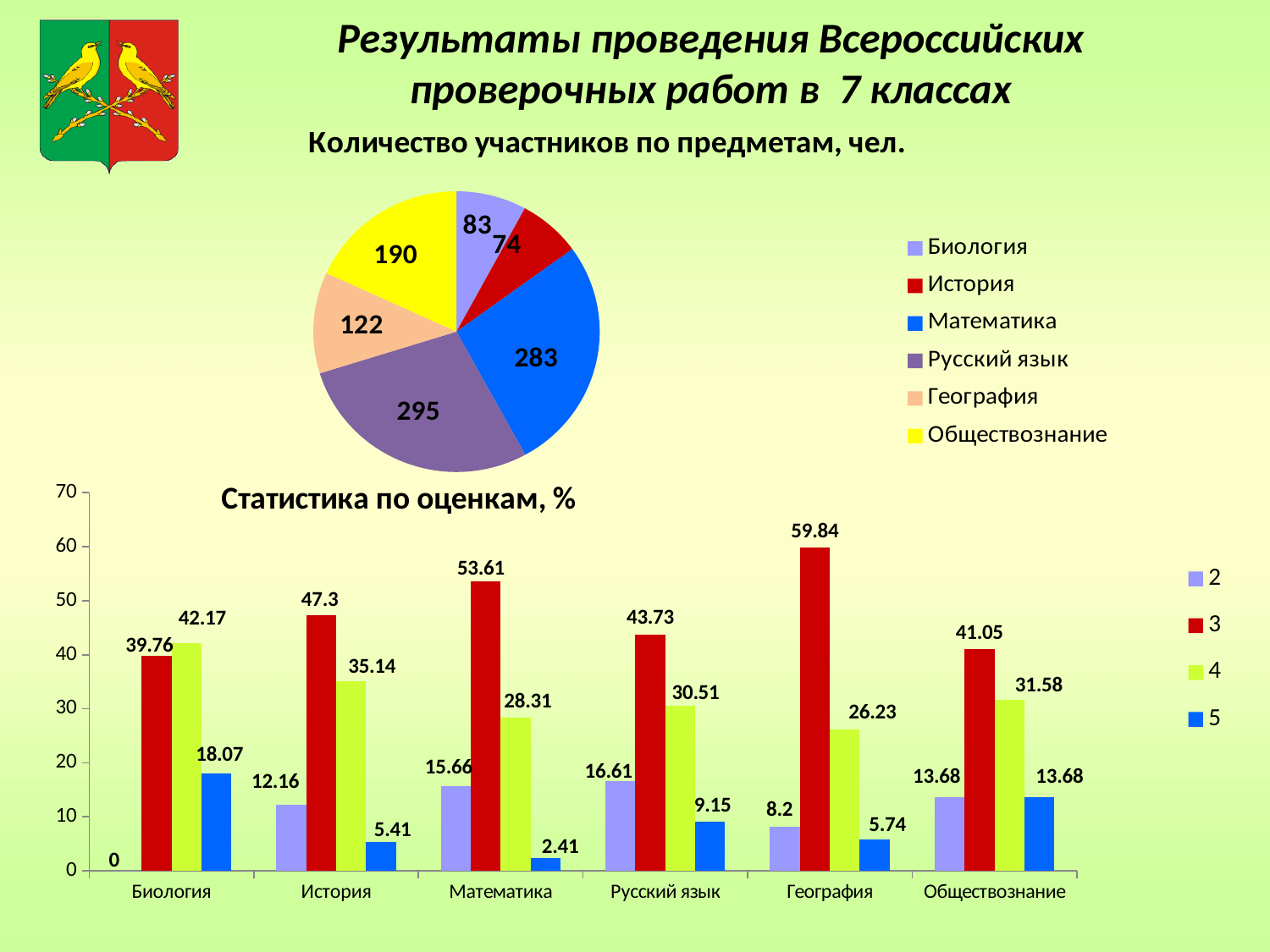
In the pie chart 'Количество участников по предметам, чел.', what is the difference between the participants for Обществознание and География? 68 In the bar chart 'Статистика по оценкам, %', which subject has the lowest value for grade 2? Биология In the bar chart 'Статистика по оценкам, %', what is the difference between the grade 4 values for Биология and Обществознание? 10.59 In the pie chart 'Количество участников по предметам, чел.', which subject has the smallest number of participants? История In the pie chart 'Количество участников по предметам, чел.', how many subjects (slices) are shown? 6 In the bar chart 'Статистика по оценкам, %', what is the value for grade 3 in География? 59.84 In the bar chart 'Статистика по оценкам, %', which is larger for История: the value for grade 3 or the value for grade 4? grade 3 In the pie chart 'Количество участников по предметам, чел.', which subject has the largest number of participants? Русский язык In the pie chart 'Количество участников по предметам, чел.', how many participants are shown for Математика? 283 In the bar chart 'Статистика по оценкам, %', what is the value for grade 5 in Математика? 2.41 How many series does the legend of the bar chart 'Статистика по оценкам, %' list? 4 In the bar chart 'Статистика по оценкам, %', which subject has the highest value for grade 3? География